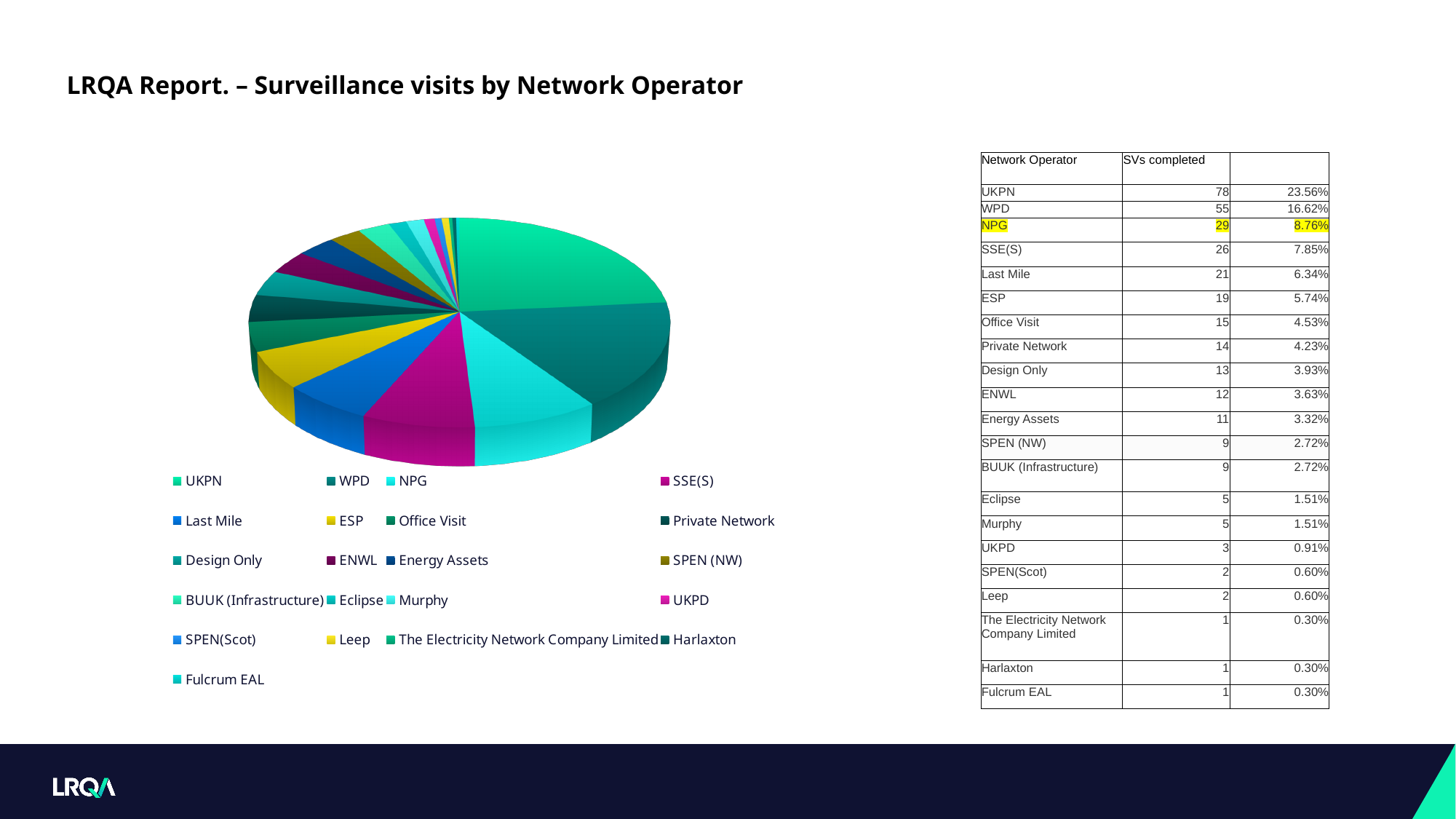
How many SVs were completed for Office Visit? 15 Which has more SVs completed, SSE(S) or Last Mile? SSE(S) Which has more SVs completed, ESP or Design Only? ESP Which network operator's row is highlighted in yellow in the table? NPG What share of the pie does NPG represent? 8.76% How many network operators are listed in the chart legend? 21 What kind of chart is shown on the slide? pie chart What is the difference in SVs completed between UKPN and WPD? 23 How many SVs were completed for NPG? 29 What percentage is shown for Energy Assets? 3.32% What percentage share does WPD have? 16.62% Which network operator has the largest slice of the pie? UKPN